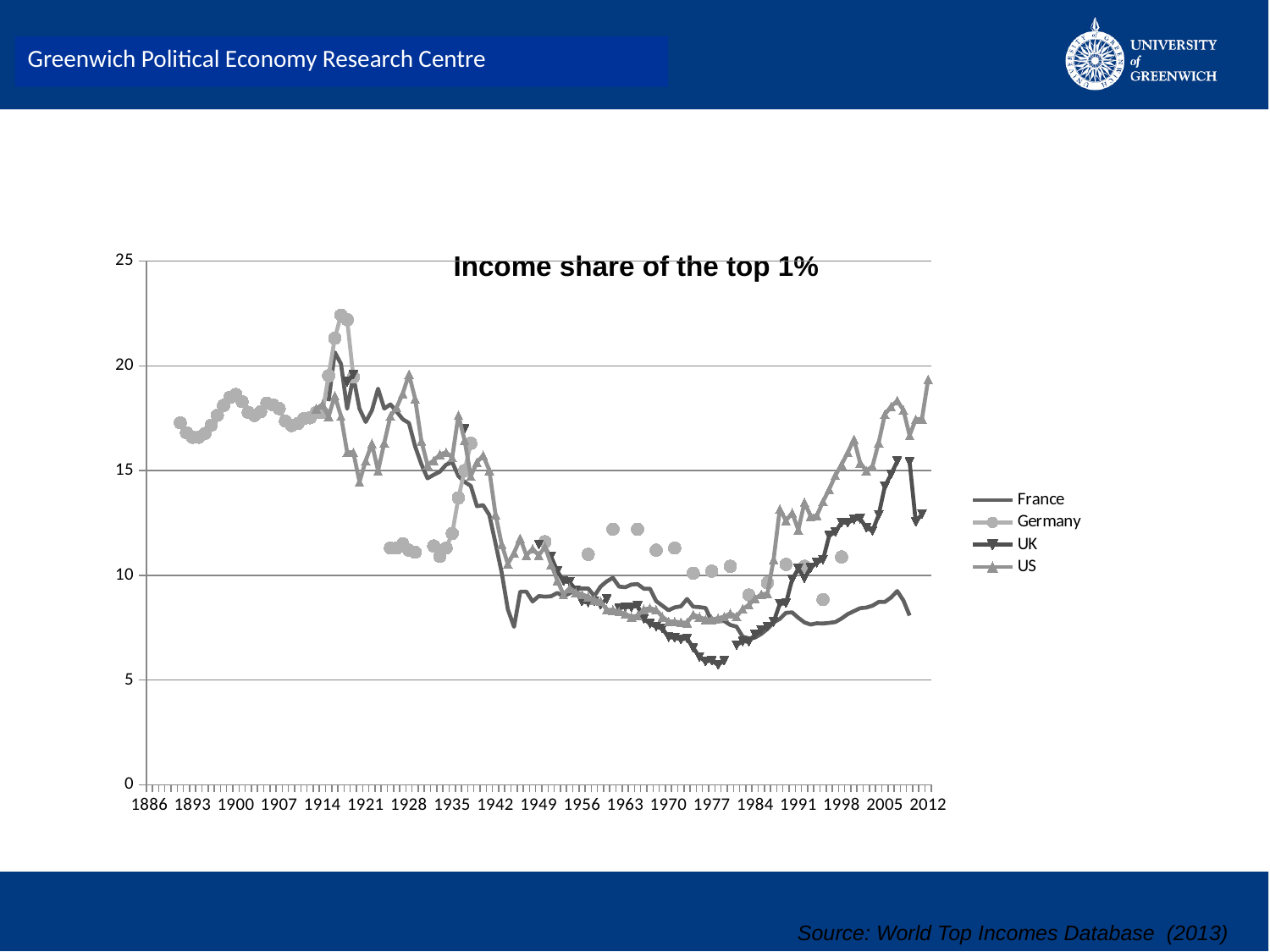
What kind of chart is shown on the slide? line chart What is the title of the chart? Income share of the top 1% Does the US series rise or fall between 1977 and 2012? rise Is the value for the US in 2012 greater or less than 15? greater Is the peak value for Germany around 1914-1921 greater or less than 20? greater Does the France series rise or fall between 1914 and 1945? fall Which series reaches the highest value anywhere on the chart? Germany Which countries are listed in the chart's legend? France, Germany, UK, US How many series does the legend list? 4 Is the value for the UK around 1977 greater or less than 10? less